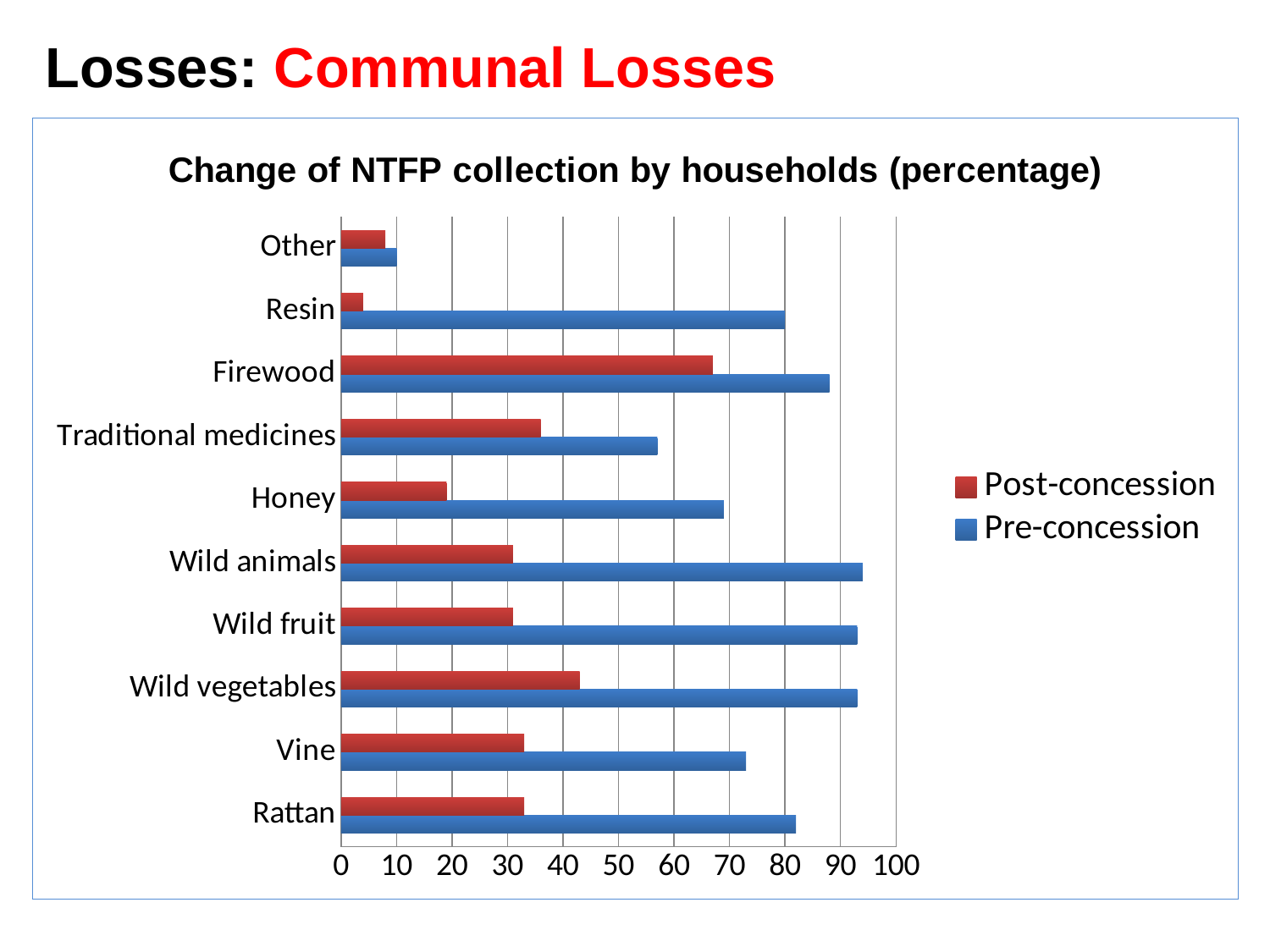
Which category has the lowest Post-concession value? Resin Is the Pre-concession value for Honey greater or less than 60? greater How many categories are shown on the chart? 10 Which category has the highest Post-concession value? Firewood What kind of chart is shown on the slide? bar chart How many series does the legend list? 2 Is the Post-concession value for Firewood greater or less than 60? greater Which category has the lowest Pre-concession value? Other Which is larger for Resin, the Pre-concession value or the Post-concession value? Pre-concession Is the Post-concession value for Honey greater or less than 30? less What is the title of the chart? Change of NTFP collection by households (percentage)